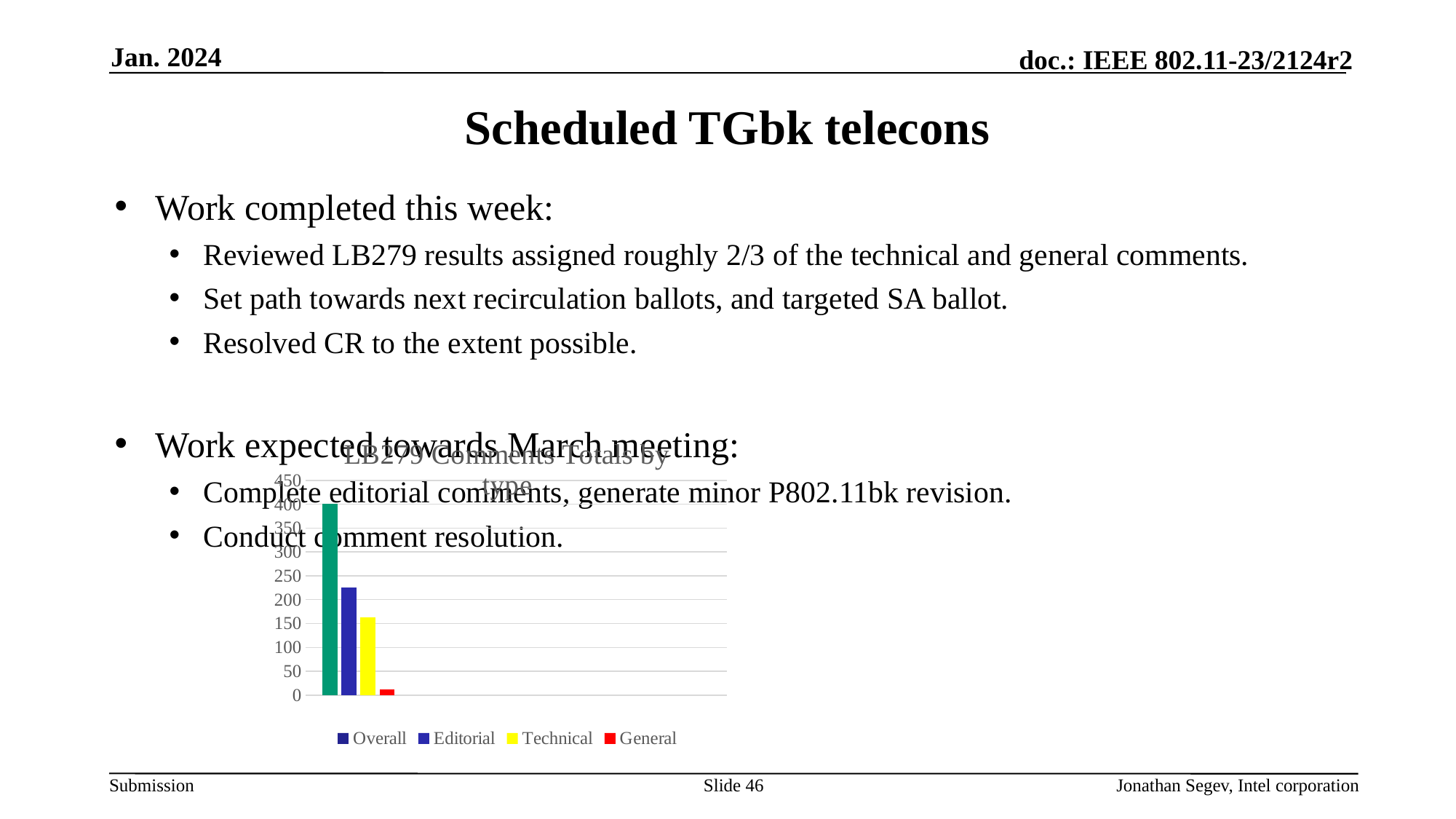
Is the value for Editorial greater or less than 250? less Is the value for Overall greater or less than 350? greater Which series has the highest value in the chart? Overall What kind of chart is shown on the slide? bar chart Is the value for Technical greater or less than 200? less How many series does the chart legend list? 4 What is the title of the chart? LB279 Comments Totals by type Which series has the lowest value in the chart? General What colour is the General series in the chart? red Which is larger, the value for Editorial or the value for Technical? Editorial Which is larger, the value for Technical or the value for General? Technical